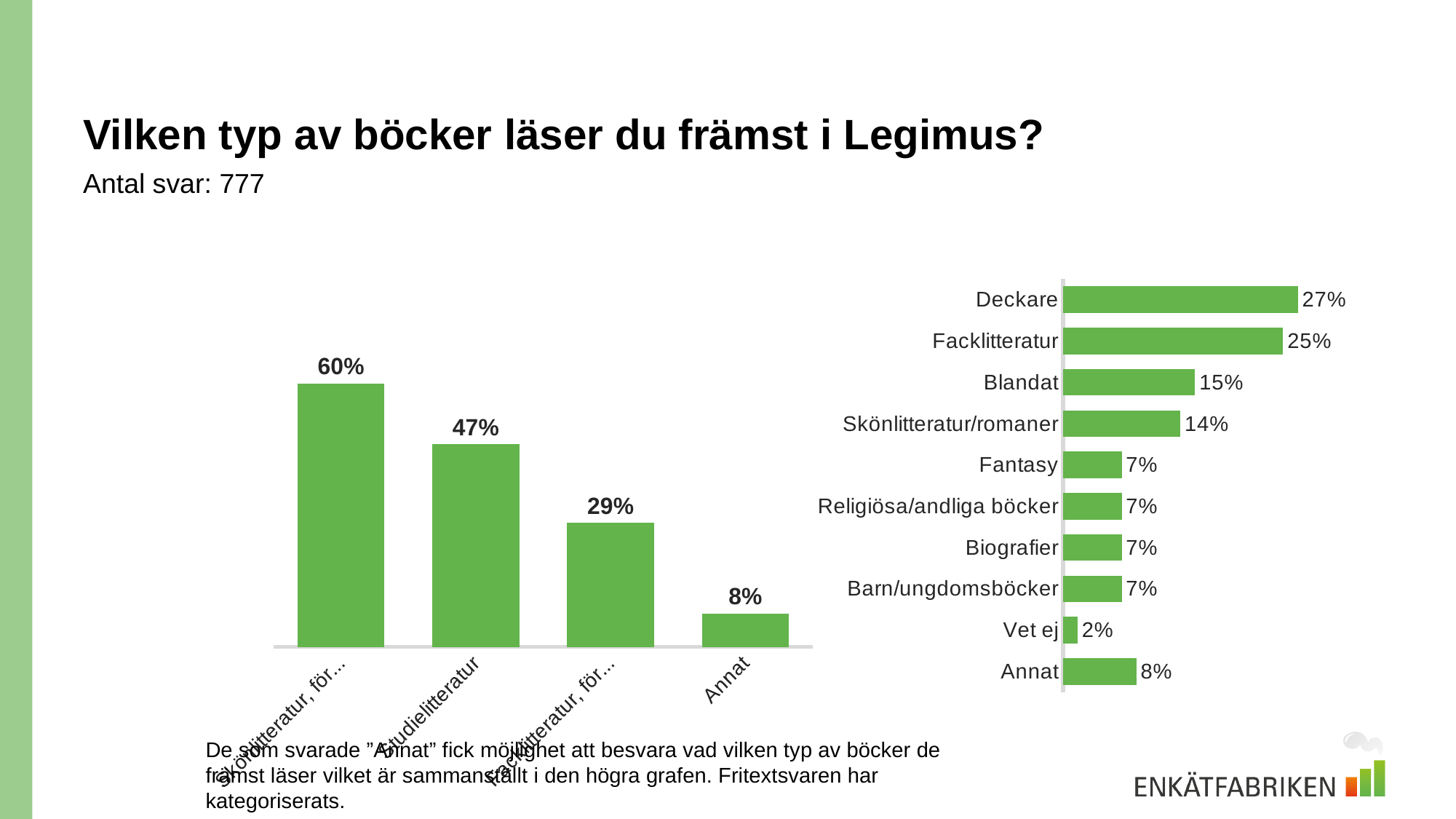
In the right chart, what is the value for Blandat? 15% In the left chart, how many bars are there? 4 In the left chart, what is the value for Studielitteratur? 47% In the left chart, what is the highest value shown? 60% In the left chart, what is the difference between the value for Studielitteratur and the value for Annat? 39% In the right chart, which category has the lowest value? Vet ej In the right chart, how many categories are listed? 10 In the right chart, what is the value for Deckare? 27% In the right chart, which category has the highest value? Deckare In the left chart, what is the value for Annat? 8% In the right chart, which is larger, Annat or Fantasy? Annat In the right chart, what is the difference between Facklitteratur and Skönlitteratur/romaner? 11%